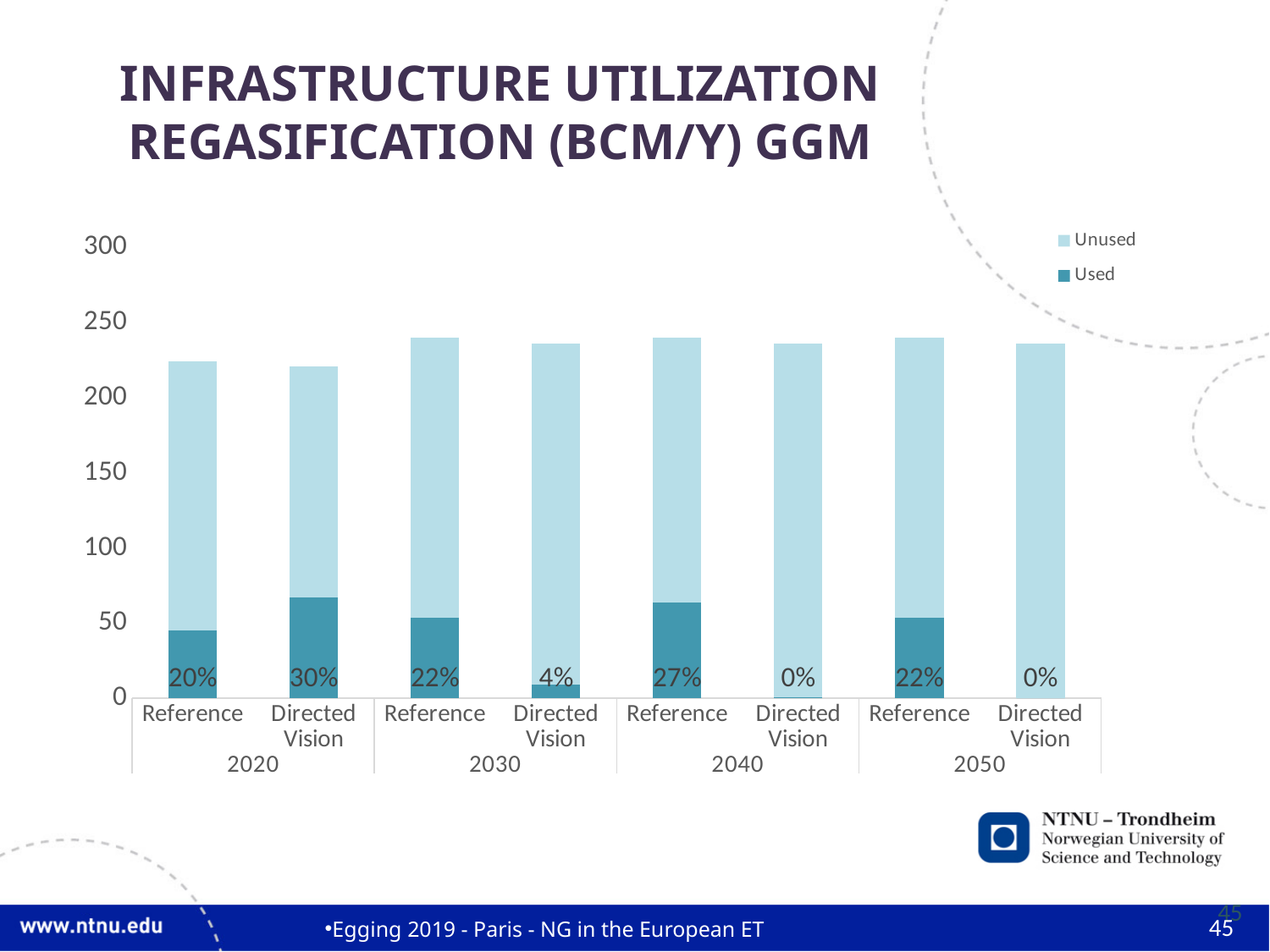
What percentage label is shown on the Directed Vision bar for 2050? 0% Is the total height of the Reference bar for 2030 greater or less than 200? greater What percentage label is shown on the Reference bar for 2040? 27% How many series does the legend list? 2 Is the total height of the Reference bar for 2020 greater or less than 250? less What kind of chart is shown on the slide? Stacked bar chart What percentage label is shown on the Reference bar for 2020? 20% Which has the larger percentage label: Reference 2020 or Directed Vision 2020? Directed Vision 2020 What percentage label is shown on the Directed Vision bar for 2030? 4% How many bars are plotted in the chart? 8 Which bar shows the highest percentage label? Directed Vision 2020 (30%) What is the difference between the percentage labels for Directed Vision 2020 and Reference 2020? 10 percentage points